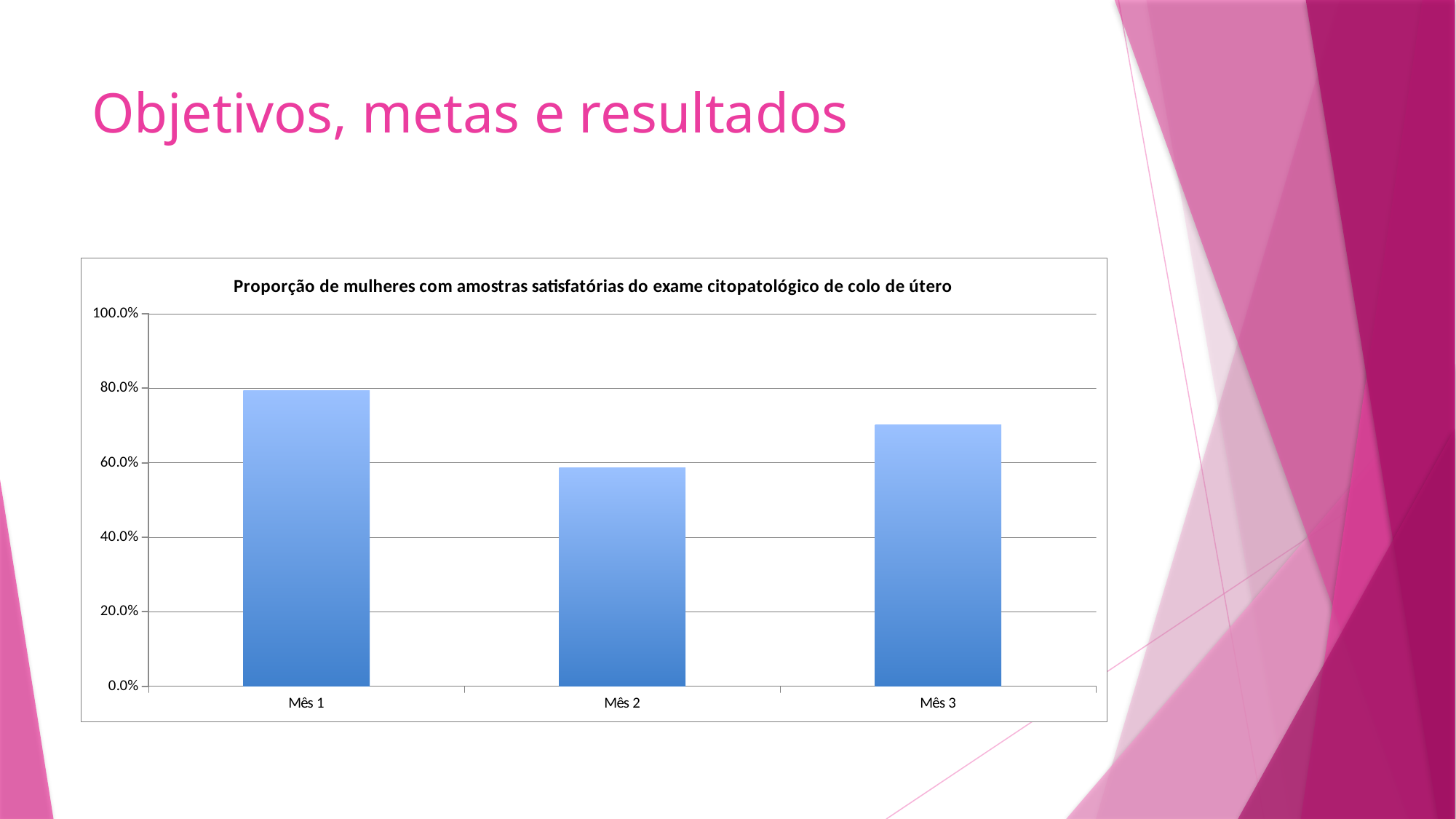
Is the value for Mês 3 greater or less than 60.0%? greater Does the value rise or fall from Mês 1 to Mês 2? fall Is the value for Mês 3 greater or less than 80.0%? less What kind of chart is shown on the slide? bar chart Is the value for Mês 1 greater or less than 60.0%? greater Which month has the highest proportion? Mês 1 Which is larger, the value for Mês 2 or the value for Mês 3? Mês 3 How many categories are plotted on the x axis? 3 Which is larger, the value for Mês 1 or the value for Mês 3? Mês 1 What is the title of the chart? Proporção de mulheres com amostras satisfatórias do exame citopatológico de colo de útero Which month has the lowest proportion? Mês 2